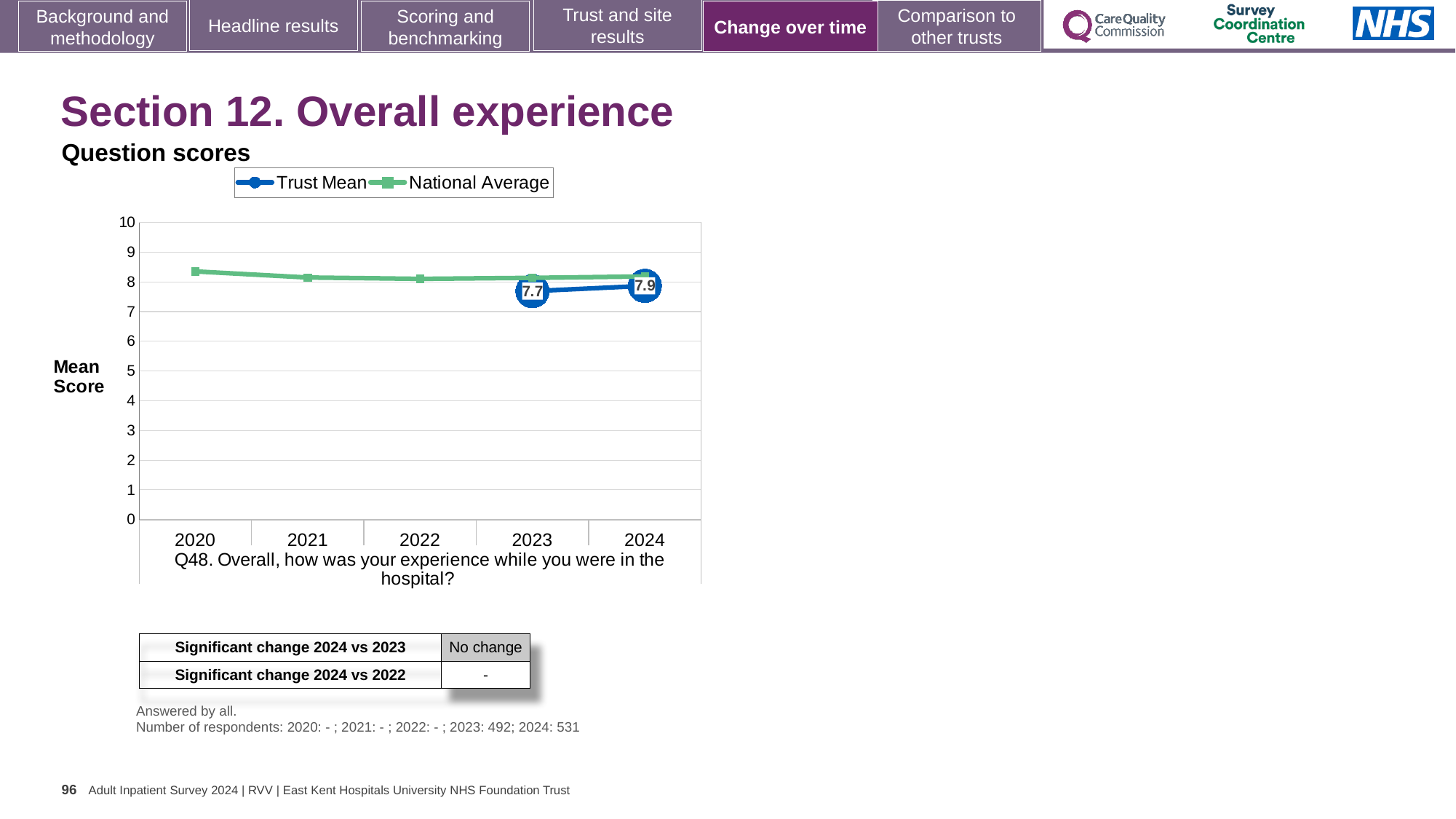
In which year is the Trust Mean lowest? 2023 How many years are shown on the x axis? 5 In which year is the Trust Mean highest? 2024 What kind of chart is shown on the slide? Line chart What is the Trust Mean value for 2024? 7.9 Which year has the higher Trust Mean value, 2023 or 2024? 2024 What is the Trust Mean value for 2023? 7.7 Is the National Average value for 2020 greater or less than 8? greater How many series does the legend list? 2 What are the two series named in the legend? Trust Mean and National Average Does the Trust Mean rise or fall from 2023 to 2024? Rise What is the difference between the Trust Mean values for 2024 and 2023? 0.2